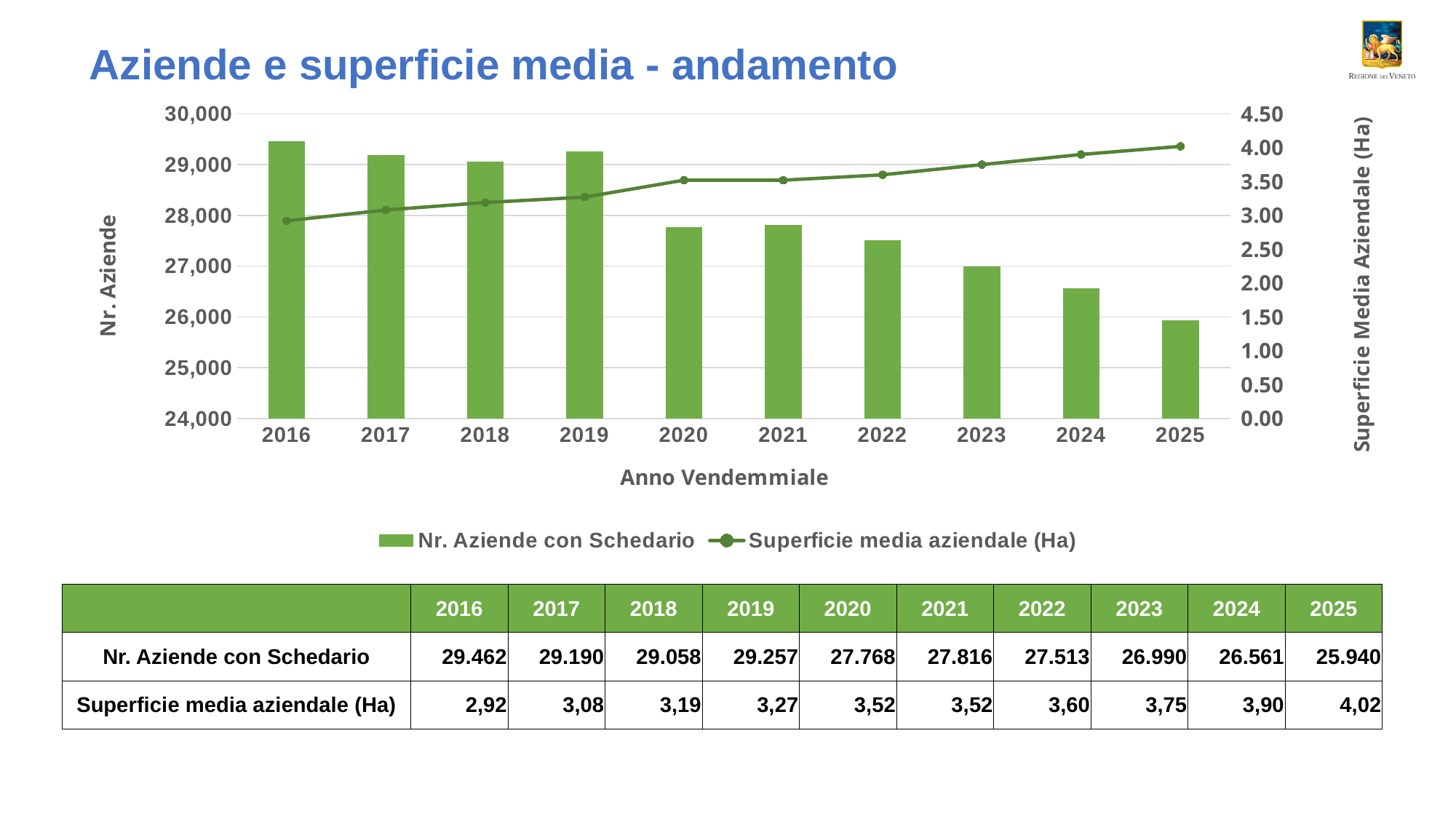
What kind of chart is shown on the slide? A bar chart combined with a line chart How many series does the chart legend list? 2 Does the Superficie media aziendale (Ha) line rise or fall from 2016 to 2025? rise Which year has the larger Nr. Aziende con Schedario, 2018 or 2019? 2019 How many years are shown on the x axis of the chart? 10 What is the value of Nr. Aziende con Schedario for 2021? 27.816 Which year has the highest Nr. Aziende con Schedario? 2016 What is the Superficie media aziendale (Ha) for 2025? 4,02 What is the value of Nr. Aziende con Schedario for 2016? 29.462 Is the Nr. Aziende con Schedario bar for 2024 greater or less than 27,000? less What is the difference in Nr. Aziende con Schedario between 2016 and 2025? 3.522 Which year has the lowest Superficie media aziendale (Ha)? 2016